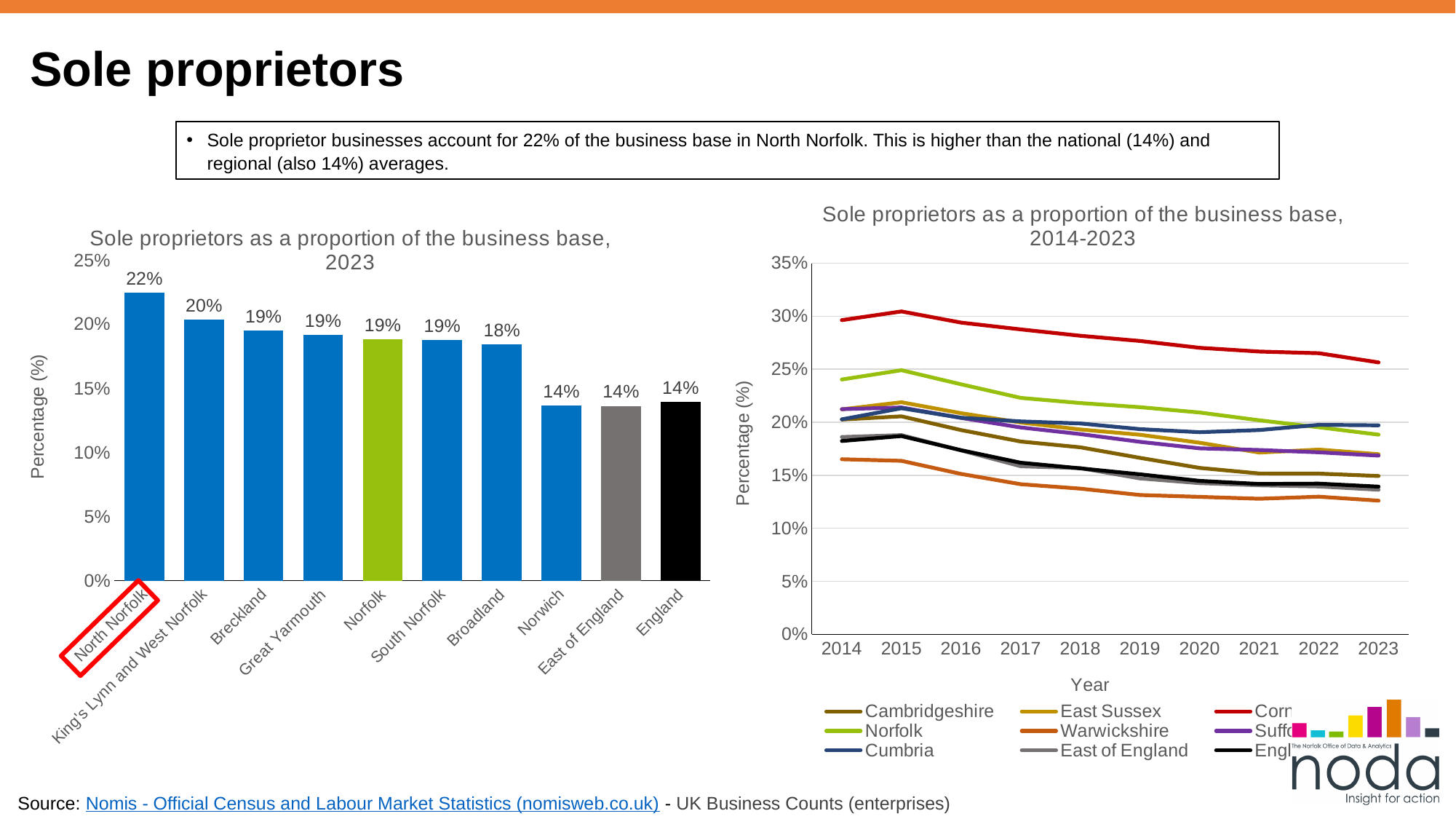
In the line chart 'Sole proprietors as a proportion of the business base, 2014-2023', is the value for Warwickshire in 2023 greater or less than 15%? less In the line chart 'Sole proprietors as a proportion of the business base, 2014-2023', does the Norfolk line rise or fall from 2014 to 2023? Fall In the line chart 'Sole proprietors as a proportion of the business base, 2014-2023', is the value for Norfolk in 2014 greater or less than 20%? greater In the bar chart 'Sole proprietors as a proportion of the business base, 2023', what is the value for Broadland? 18% In the bar chart 'Sole proprietors as a proportion of the business base, 2023', what is the difference between the values for North Norfolk and England? 8 percentage points What kind of chart is the chart titled 'Sole proprietors as a proportion of the business base, 2014-2023'? Line chart What kind of chart is the chart on the left of the slide? Bar chart How many categories are shown in the bar chart 'Sole proprietors as a proportion of the business base, 2023'? 10 In the bar chart 'Sole proprietors as a proportion of the business base, 2023', which category has the highest value? North Norfolk In the bar chart 'Sole proprietors as a proportion of the business base, 2023', what is the value for King's Lynn and West Norfolk? 20% In the bar chart 'Sole proprietors as a proportion of the business base, 2023', which is larger, the value for Broadland or the value for Norwich? Broadland In the bar chart 'Sole proprietors as a proportion of the business base, 2023', what is the value for North Norfolk? 22%